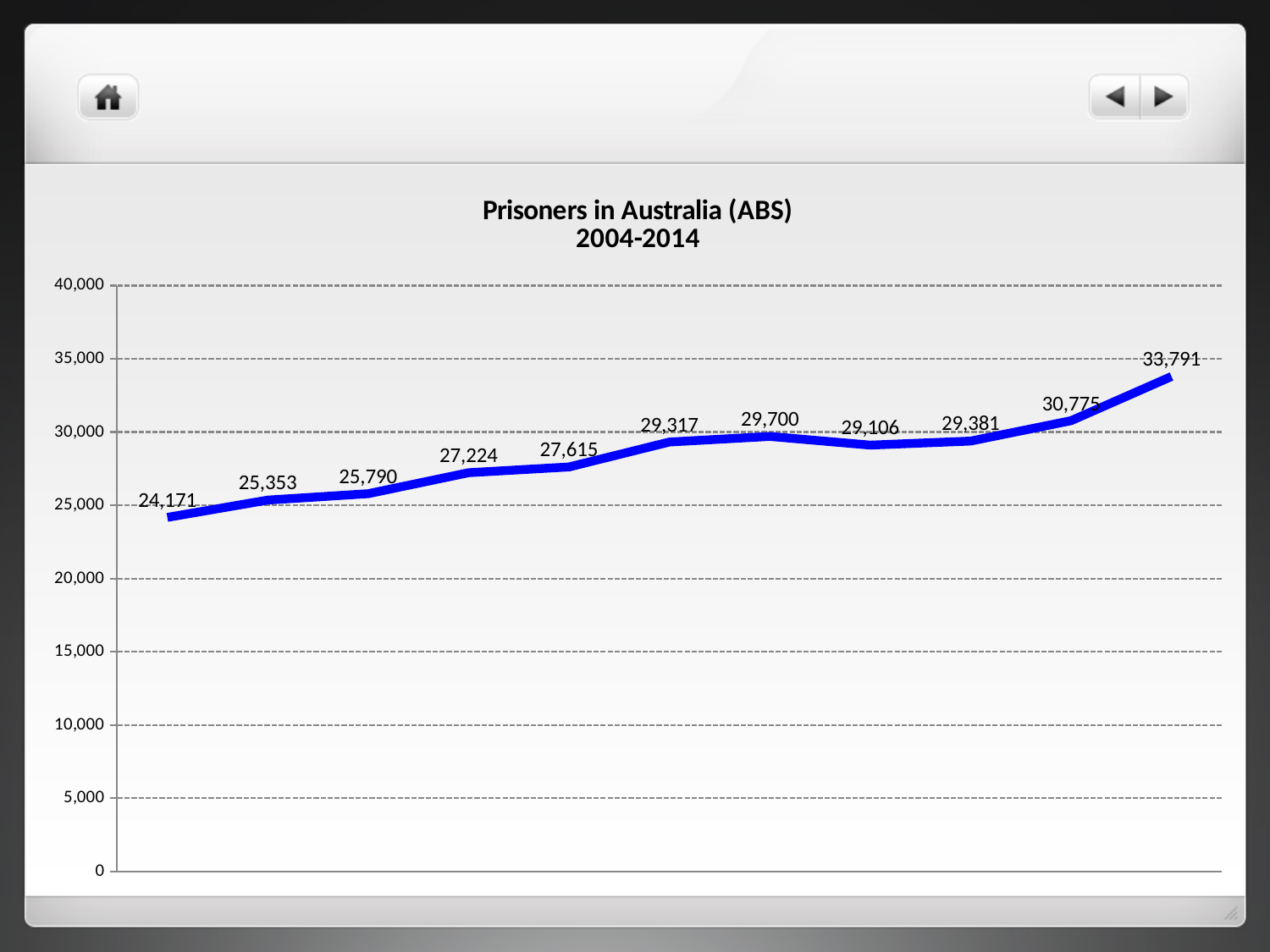
What is the difference between the last data point (33,791) and the first data point (24,171)? 9,620 What is the value of the last data point on the line? 33,791 What type of chart is shown on the slide? Line chart What is the highest value plotted on the chart? 33,791 Which is larger, the seventh data point (29,700) or the eighth data point (29,106)? 29,700 How many data points are plotted on the line? 11 What is the lowest value plotted on the chart? 24,171 What is the value of the first data point on the line? 24,171 What is the title of the chart? Prisoners in Australia (ABS) 2004-2014 Overall, do the values rise or fall from left to right along the line? Rise What is the value of the fourth data point on the line? 27,224 Is the value of the last data point greater or less than 30,000? greater